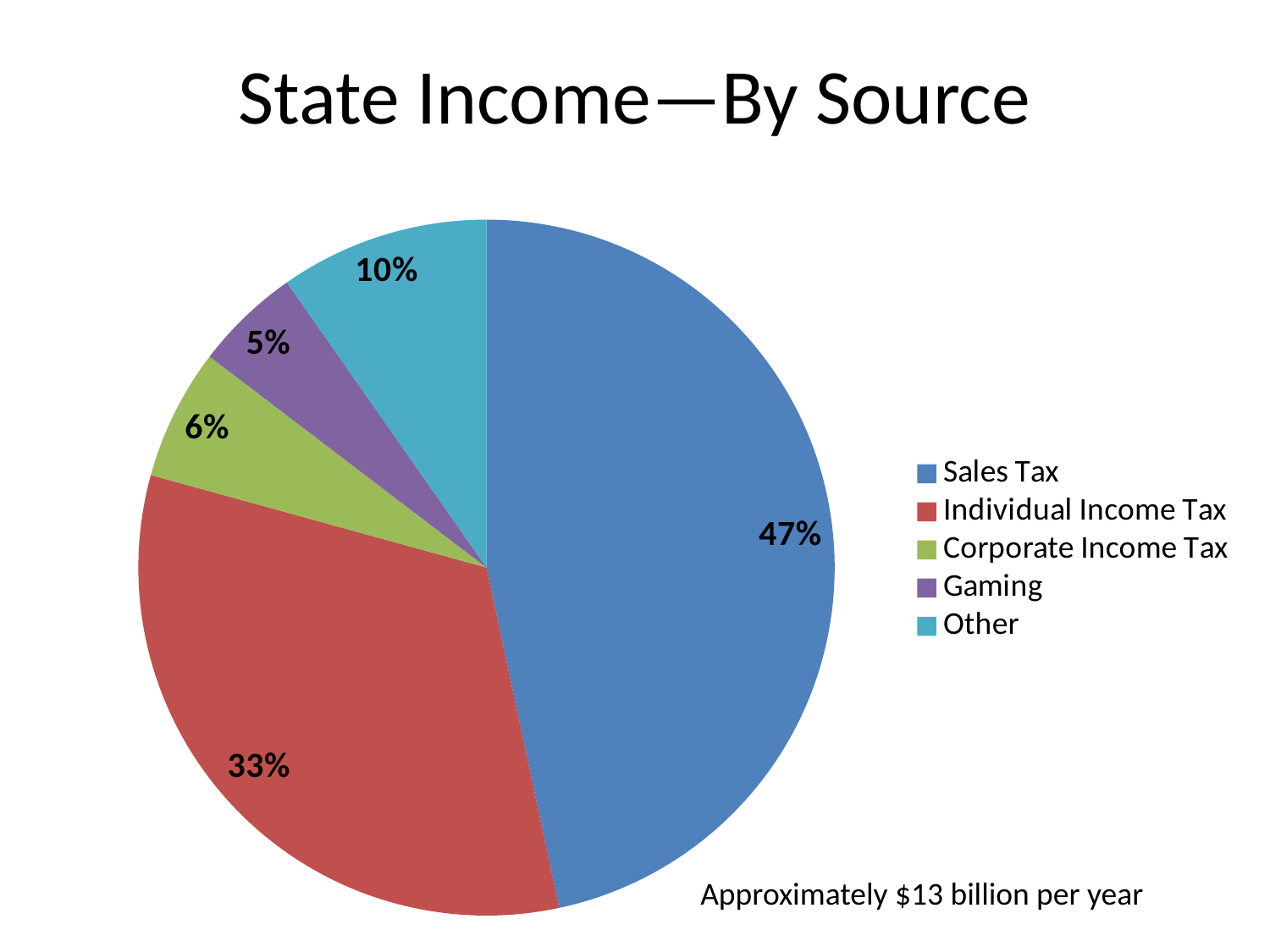
Which source accounts for the smallest share of state income? Gaming What percentage does Corporate Income Tax contribute? 6% What kind of chart is shown on the slide? Pie chart How many sources are shown in the pie chart? 5 What is the difference in percentage points between Sales Tax and Individual Income Tax? 14 What share of state income comes from Sales Tax? 47% Which source accounts for the largest share of state income? Sales Tax What share of state income comes from Gaming? 5% What percentage is labelled for the Other slice? 10% What is the title of the chart? State Income—By Source What percentage of state income is from Individual Income Tax? 33% Which is larger, the share for Other or the share for Corporate Income Tax? Other